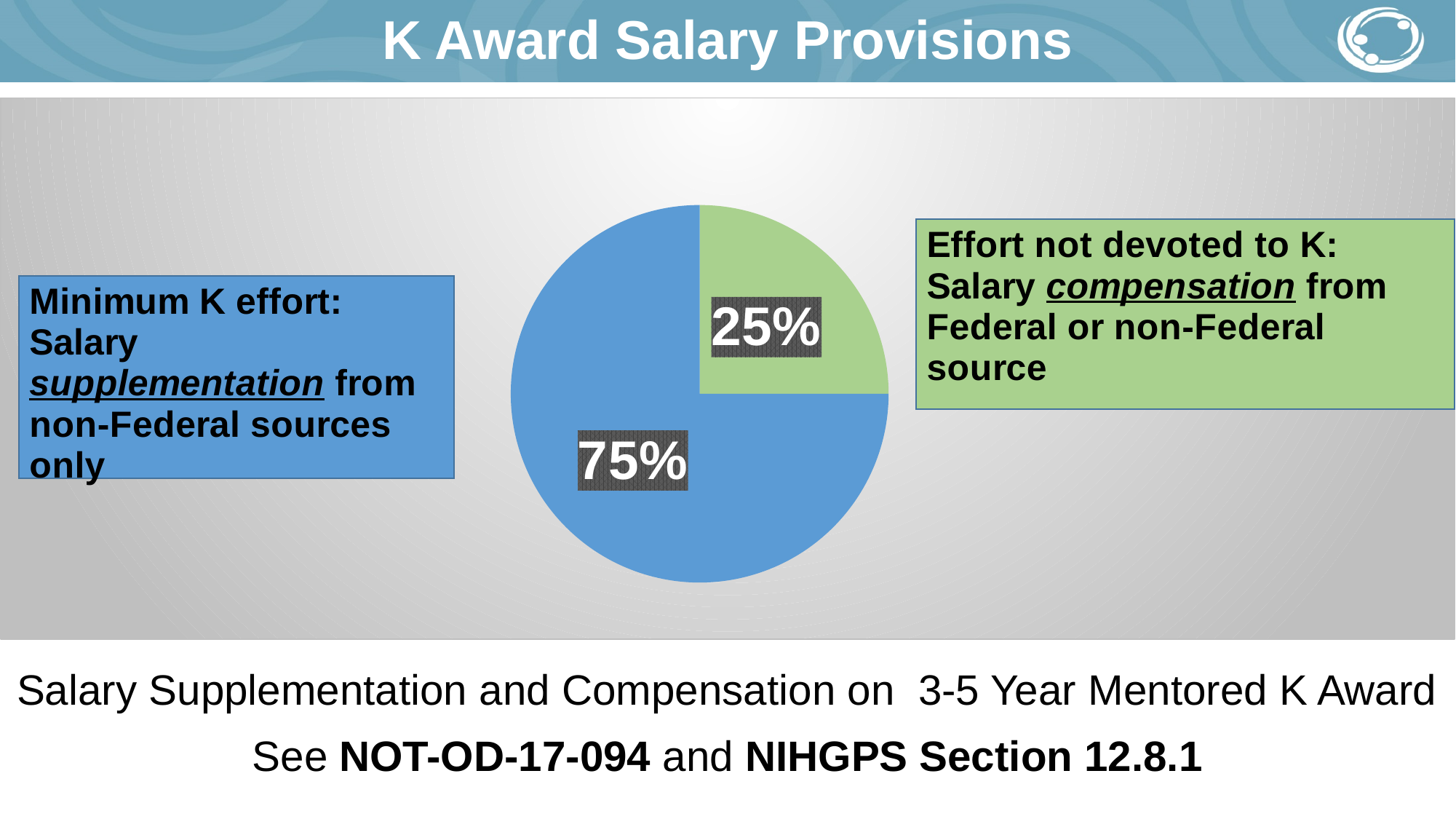
Which slice of the pie is the largest? Minimum K effort (75%) Which is larger: the blue slice or the green slice? the blue slice What kind of chart is shown on the slide? pie chart What share of the pie does the green slice (Effort not devoted to K) represent? 25% How many slices does the pie chart have? 2 What is the total of the two slices shown in the pie chart? 100% What colour is the slice labelled 75%? blue Which slice of the pie is the smallest? Effort not devoted to K (25%) What share of the pie does the blue slice (Minimum K effort) represent? 75% What is the title of the slide containing the pie chart? K Award Salary Provisions What is the difference in percentage points between the 75% slice and the 25% slice? 50